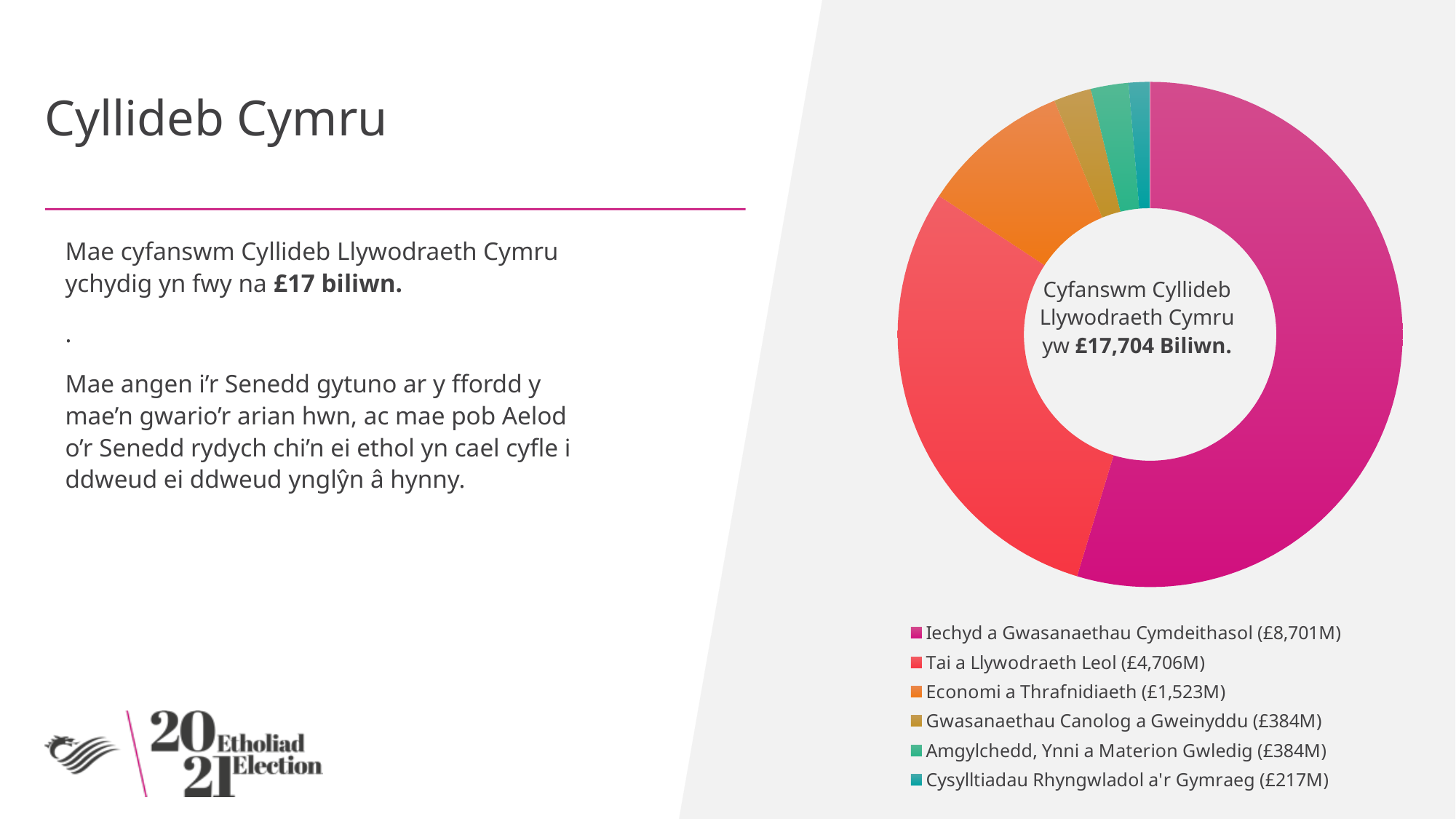
What value does the legend give for Economi a Thrafnidiaeth? £1,523M How many categories does the chart show? 6 Which is larger: Tai a Llywodraeth Leol or Economi a Thrafnidiaeth? Tai a Llywodraeth Leol What total is printed in the centre of the chart? £17,704 Biliwn What value does the legend give for Tai a Llywodraeth Leol? £4,706M What kind of chart is shown on the slide? Doughnut (pie) chart What value does the legend give for Iechyd a Gwasanaethau Cymdeithasol? £8,701M What value does the legend give for Cysylltiadau Rhyngwladol a'r Gymraeg? £217M What is the difference between the values for Economi a Thrafnidiaeth and Gwasanaethau Canolog a Gweinyddu? £1,139M What is the difference between the values for Iechyd a Gwasanaethau Cymdeithasol and Tai a Llywodraeth Leol? £3,995M Which category has the smallest value in the chart? Cysylltiadau Rhyngwladol a'r Gymraeg Which category has the largest share of the chart? Iechyd a Gwasanaethau Cymdeithasol